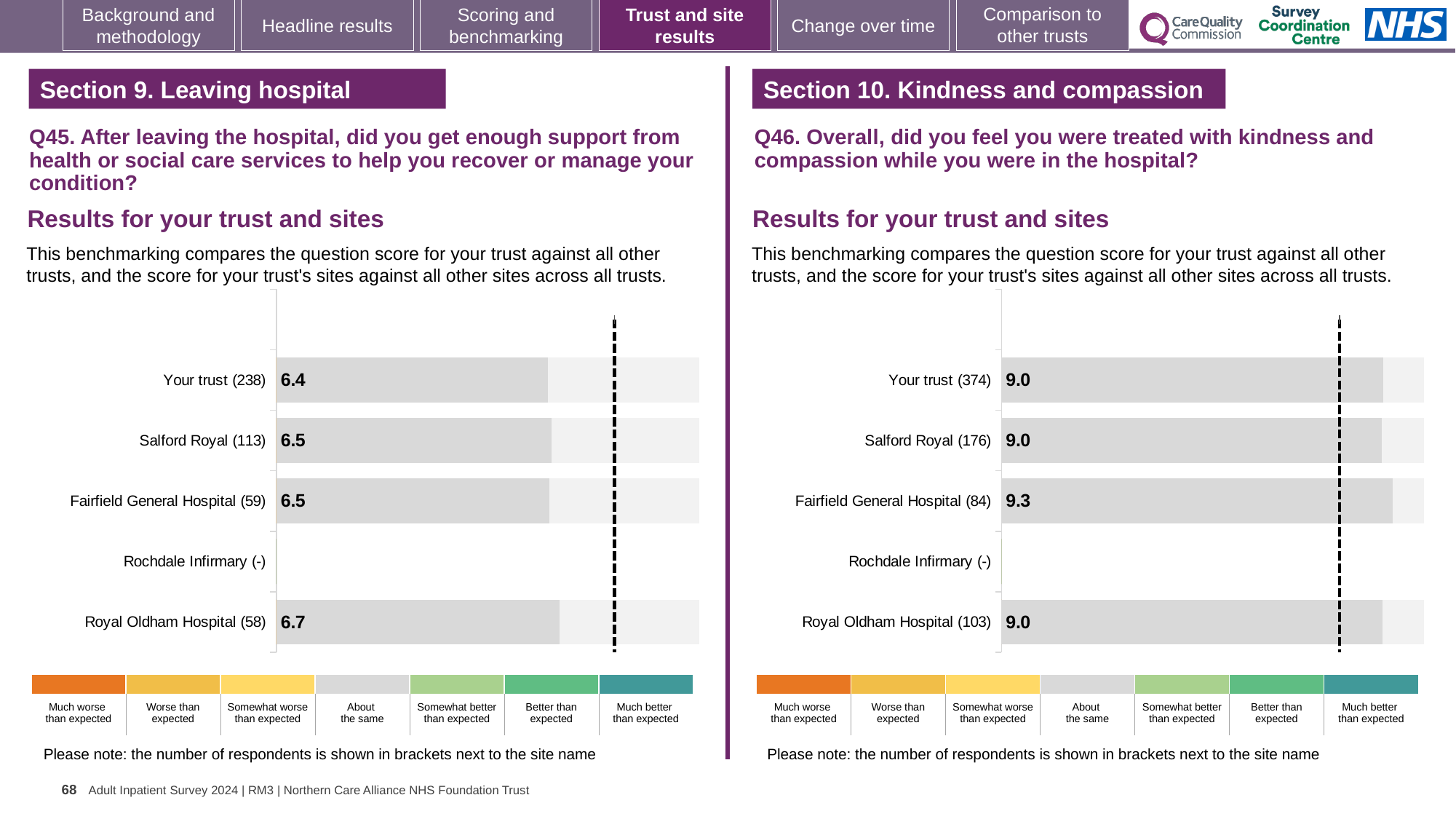
In the Q46 chart on the right, how many respondents are shown for Your trust? 374 In the Q46 chart on the right, what is the score for Fairfield General Hospital? 9.3 In the Q45 chart on the left, what is the difference between the scores for Royal Oldham Hospital and Your trust? 0.3 In the Q46 chart on the right, what is the difference between the scores for Fairfield General Hospital and Your trust? 0.3 In the Q46 chart on the right, which site has the highest score? Fairfield General Hospital In the Q45 chart on the left, how many respondents are shown for Salford Royal? 113 What kind of chart is used for the Q46 results on the right? bar chart How many sites or categories are listed in the Q45 chart on the left? 5 In the Q45 chart on the left, what is the score for Royal Oldham Hospital? 6.7 In the Q46 chart on the right, is the score for Fairfield General Hospital larger or smaller than the score for Salford Royal? larger In the Q45 chart on the left, which site has the highest score? Royal Oldham Hospital In the Q45 chart on the left, what is the score for Your trust? 6.4